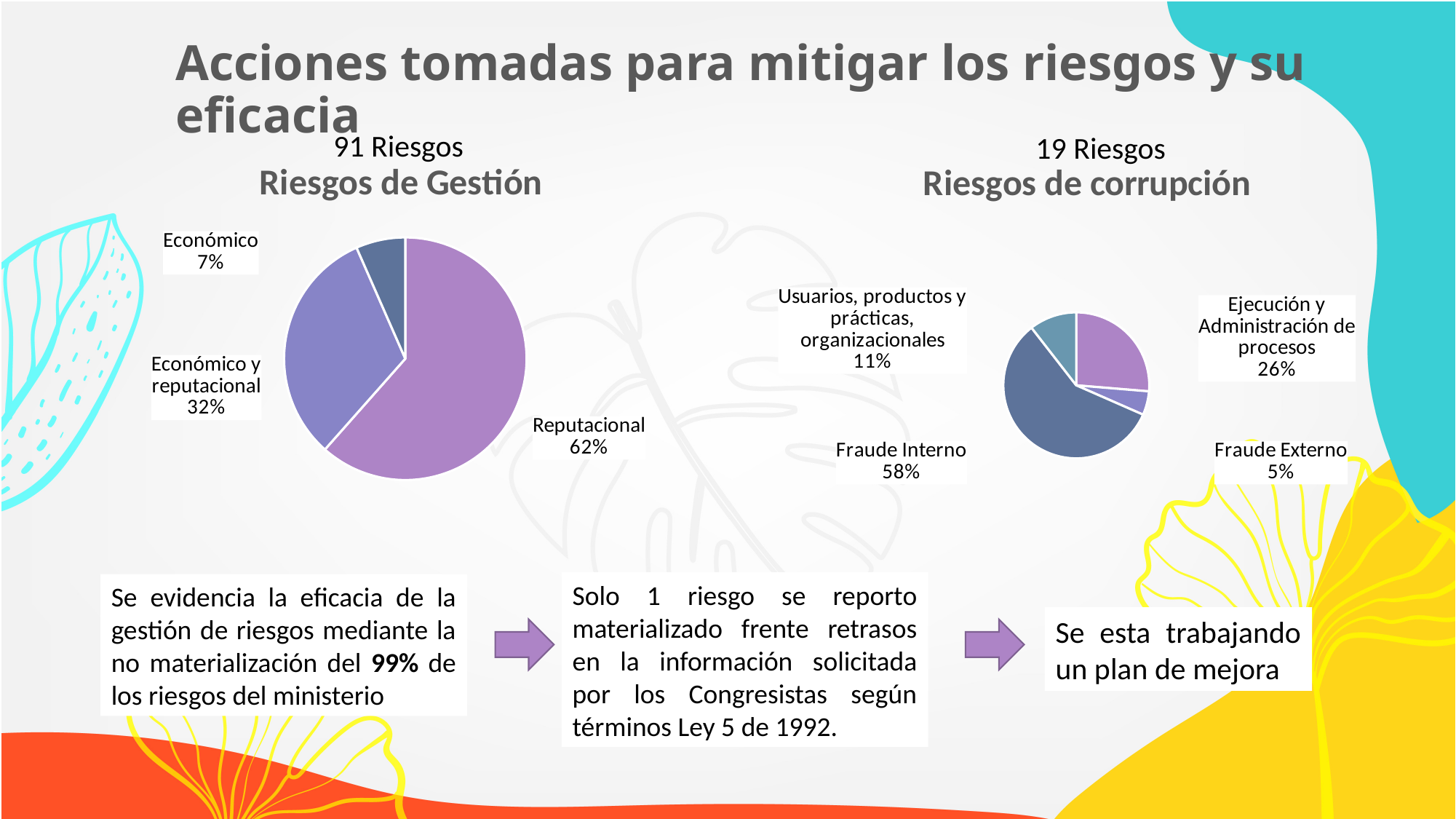
In the 'Riesgos de corrupción' chart, which is larger: Usuarios, productos y prácticas, organizacionales or Ejecución y Administración de procesos? Ejecución y Administración de procesos In the 'Riesgos de Gestión' chart, what is the difference between the Reputacional and Económico y reputacional shares? 30 percentage points In the 'Riesgos de Gestión' chart, how many slices does the pie have? 3 In the 'Riesgos de Gestión' chart, which category has the largest slice? Reputacional In the 'Riesgos de corrupción' chart, what share does Ejecución y Administración de procesos have? 26% In the 'Riesgos de corrupción' chart, what share does Fraude Interno have? 58% In the 'Riesgos de corrupción' chart, how many categories are shown? 4 In the 'Riesgos de Gestión' chart, what share does Económico have? 7% In the 'Riesgos de corrupción' chart, which category has the smallest slice? Fraude Externo What type of chart is used for 'Riesgos de corrupción'? Pie chart In the 'Riesgos de Gestión' chart, what share does Reputacional have? 62% In the 'Riesgos de Gestión' chart, which category has the smallest slice? Económico